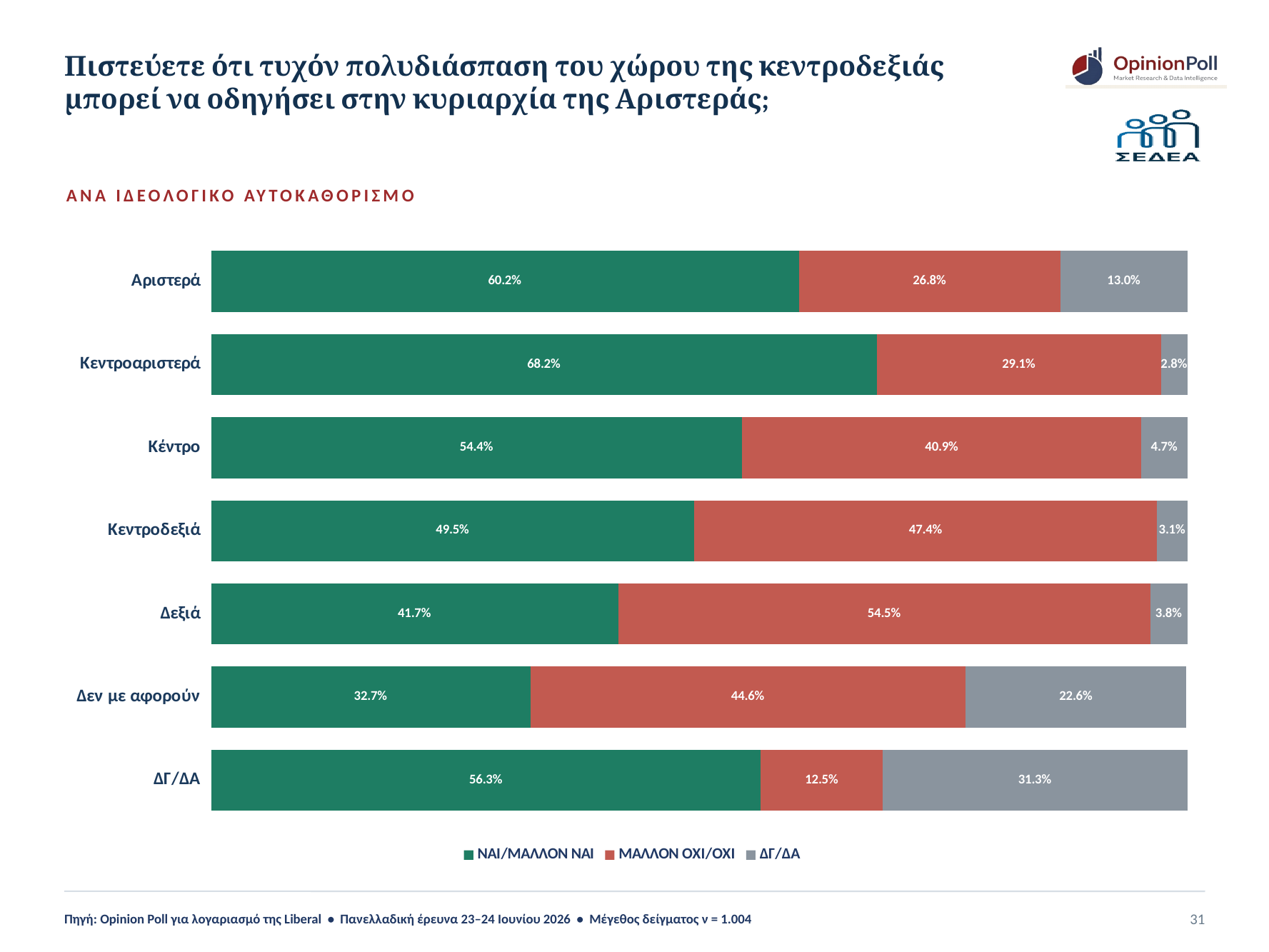
Which category has the highest ΝΑΙ/ΜΑΛΛΟΝ ΝΑΙ value? Κεντροαριστερά What kind of chart is shown on the slide? Stacked bar chart What is the difference in percentage points between the ΝΑΙ/ΜΑΛΛΟΝ ΝΑΙ values for Κεντροαριστερά and Δεξιά? 26.5 What percentage of respondents who self-identify as Αριστερά answered ΝΑΙ/ΜΑΛΛΟΝ ΝΑΙ? 60.2% How many categories are shown on the chart? 7 What is the ΜΑΛΛΟΝ ΟΧΙ/ΟΧΙ value for the Κέντρο category? 40.9% Which category has the lowest ΝΑΙ/ΜΑΛΛΟΝ ΝΑΙ value? Δεν με αφορούν Which category has the highest ΜΑΛΛΟΝ ΟΧΙ/ΟΧΙ value? Δεξιά What is the ΔΓ/ΔΑ share for the Δεν με αφορούν category? 22.6% Which is larger for the Κεντροδεξιά category: ΝΑΙ/ΜΑΛΛΟΝ ΝΑΙ or ΜΑΛΛΟΝ ΟΧΙ/ΟΧΙ? ΝΑΙ/ΜΑΛΛΟΝ ΝΑΙ Which category has the lowest ΔΓ/ΔΑ value? Κεντροαριστερά How many series does the legend list? 3